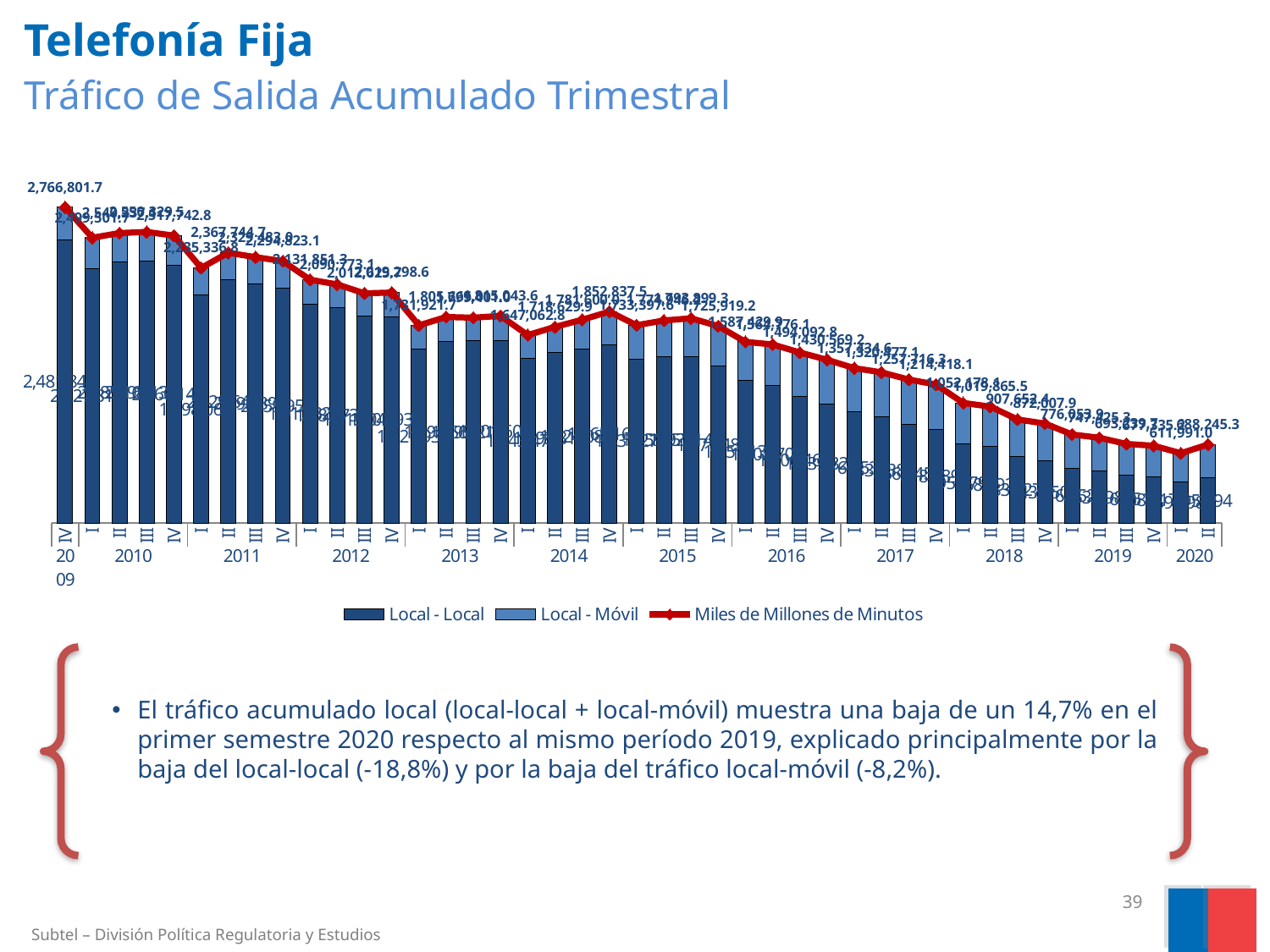
Which quarter has the lowest value on the Miles de Millones de Minutos line? 2020 I Which quarter has the highest value on the Miles de Millones de Minutos line? 2009 IV How many years are labelled along the x axis of the chart? 12 What is the value of the Miles de Millones de Minutos line for 2009 IV? 2,766,801.7 How many series does the chart legend list? 3 What is the title of the chart? Tráfico de Salida Acumulado Trimestral Which is larger, the Miles de Millones de Minutos value for 2009 IV or for 2020 II? 2009 IV What kind of chart is shown on the slide? combination bar and line chart (stacked bars with a line) What is the value of the Miles de Millones de Minutos line for 2020 I? 611,991.0 Which series is shown as the dark blue bottom segment of each stacked bar? Local - Local What are the entries in the chart legend? Local - Local, Local - Móvil, Miles de Millones de Minutos Do the values of the Miles de Millones de Minutos line generally rise or fall from left to right along the x axis? fall